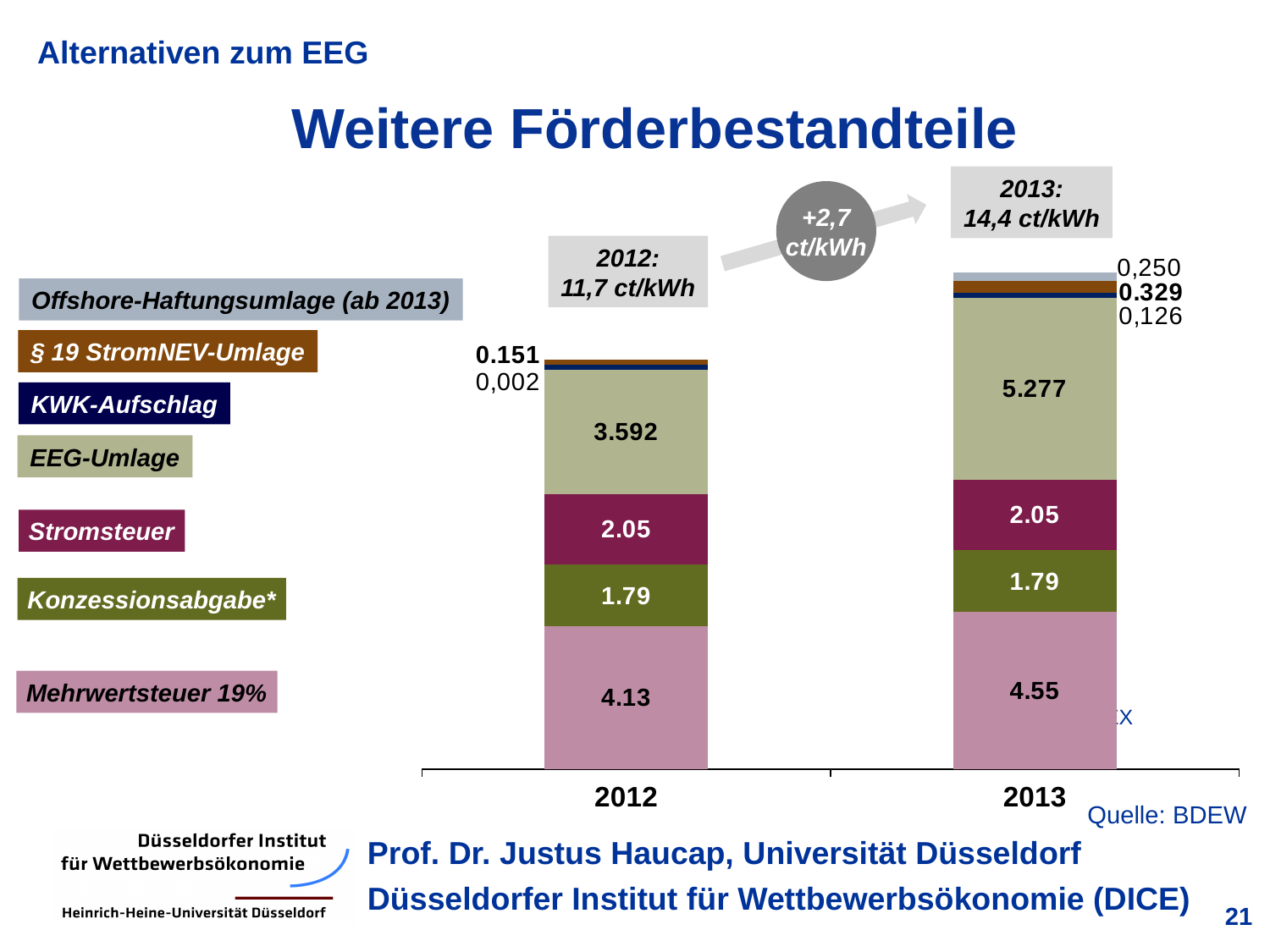
What kind of chart is shown on the slide? Stacked bar chart What is the value of the Mehrwertsteuer 19% segment for 2013? 4.55 What is the value of the EEG-Umlage segment for 2012? 3.592 What is the total of the stacked bar for 2012? 11,7 ct/kWh What is the value of the EEG-Umlage segment for 2013? 5.277 What is the value of the § 19 StromNEV-Umlage segment for 2012? 0.151 By how much did the total increase from 2012 to 2013? 2,7 ct/kWh What is the value of the Offshore-Haftungsumlage segment for 2013? 0,250 Which year has the larger Mehrwertsteuer 19% value, 2012 or 2013? 2013 Which segment is the largest in the 2013 bar? EEG-Umlage What is the total of the stacked bar for 2013? 14,4 ct/kWh How many series does the legend list? 7